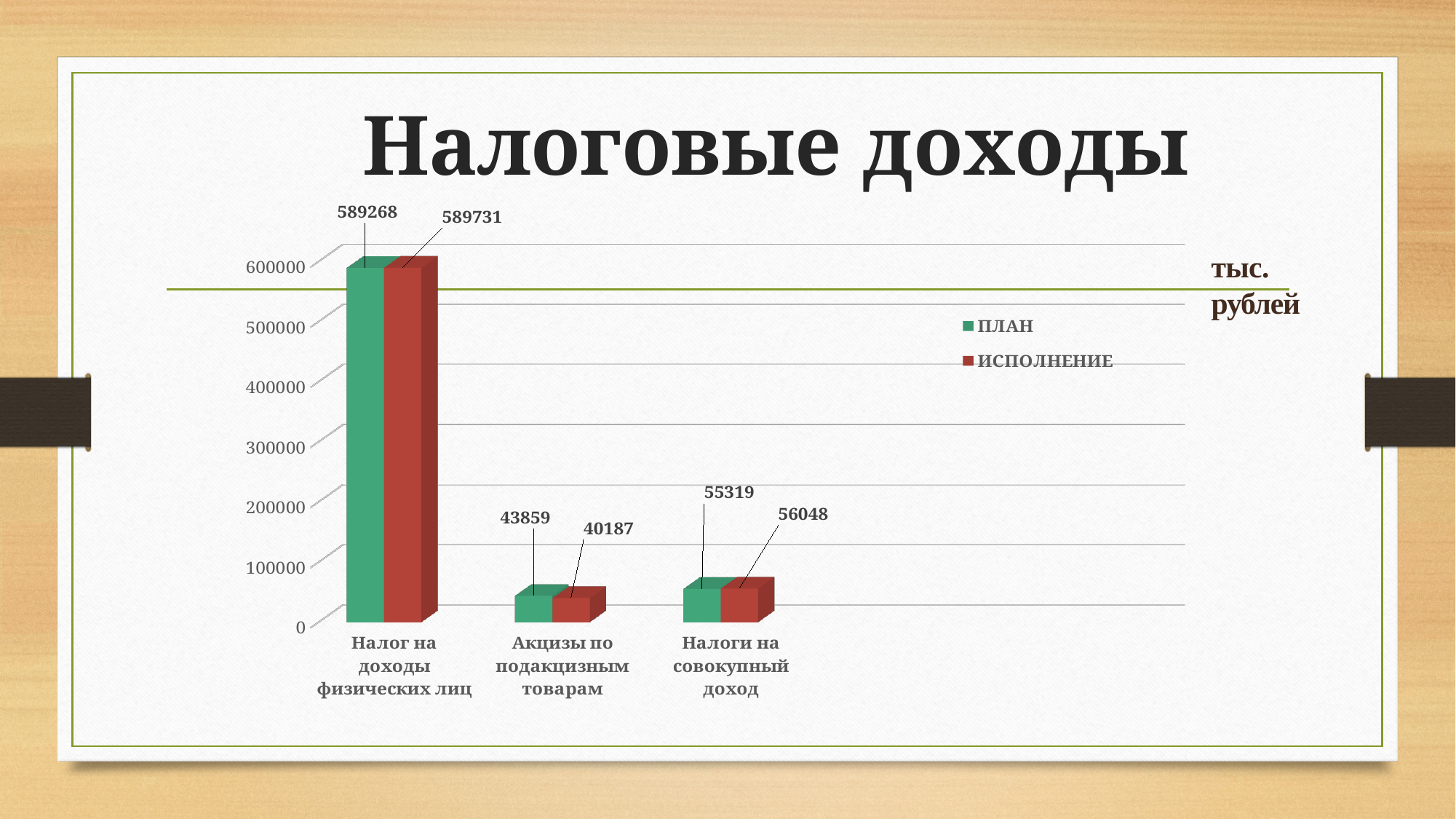
What is the ИСПОЛНЕНИЕ value for Налоги на совокупный доход? 56048 How many categories are shown on the x axis? 3 Is the ПЛАН value for Налог на доходы физических лиц greater or less than 500000? greater What kind of chart is shown on the slide? bar chart For Налоги на совокупный доход, which is larger: ПЛАН or ИСПОЛНЕНИЕ? ИСПОЛНЕНИЕ Which category has the lowest ИСПОЛНЕНИЕ value? Акцизы по подакцизным товарам What is the difference between the ПЛАН and ИСПОЛНЕНИЕ values for Акцизы по подакцизным товарам? 3672 How many series does the legend list? 2 What is the ПЛАН value for Налог на доходы физических лиц? 589268 What is the ПЛАН value for Налоги на совокупный доход? 55319 What is the ИСПОЛНЕНИЕ value for Акцизы по подакцизным товарам? 40187 Which category has the highest ПЛАН value? Налог на доходы физических лиц